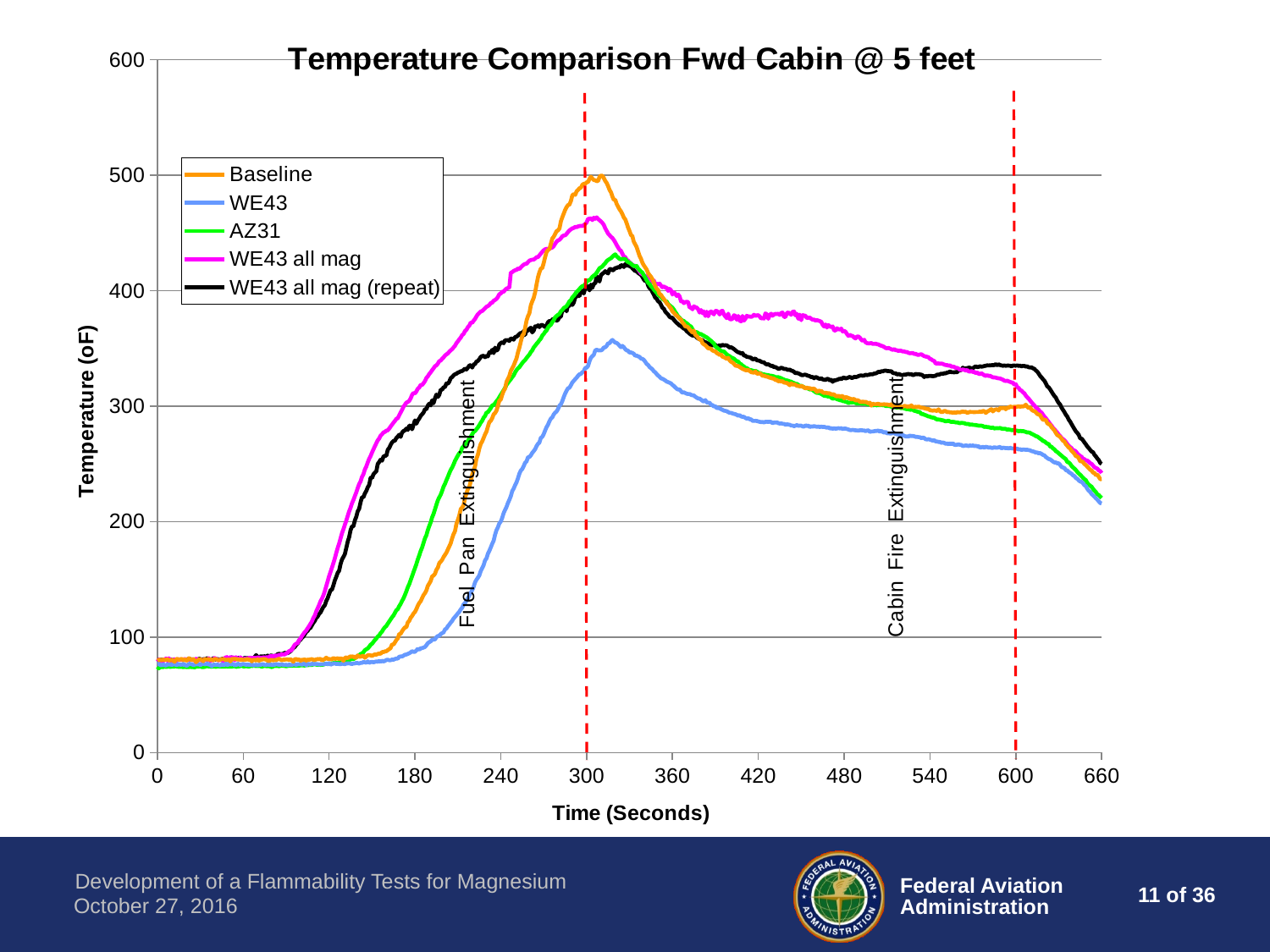
What is the title of the chart? Temperature Comparison Fwd Cabin @ 5 feet How many series does the legend list? 5 At 600 seconds, is the value for WE43 greater or less than 300? less Which series reaches the highest peak temperature? Baseline Is the peak value of the WE43 series greater or less than 400? less At 600 seconds, is the value for WE43 all mag (repeat) greater or less than 300? greater At 420 seconds, which series has the higher temperature, WE43 all mag or WE43? WE43 all mag Between 300 and 360 seconds, does the Baseline series rise or fall? fall What kind of chart is shown on the slide? line chart Which series has the lowest peak temperature? WE43 What is the label of the x axis? Time (Seconds)